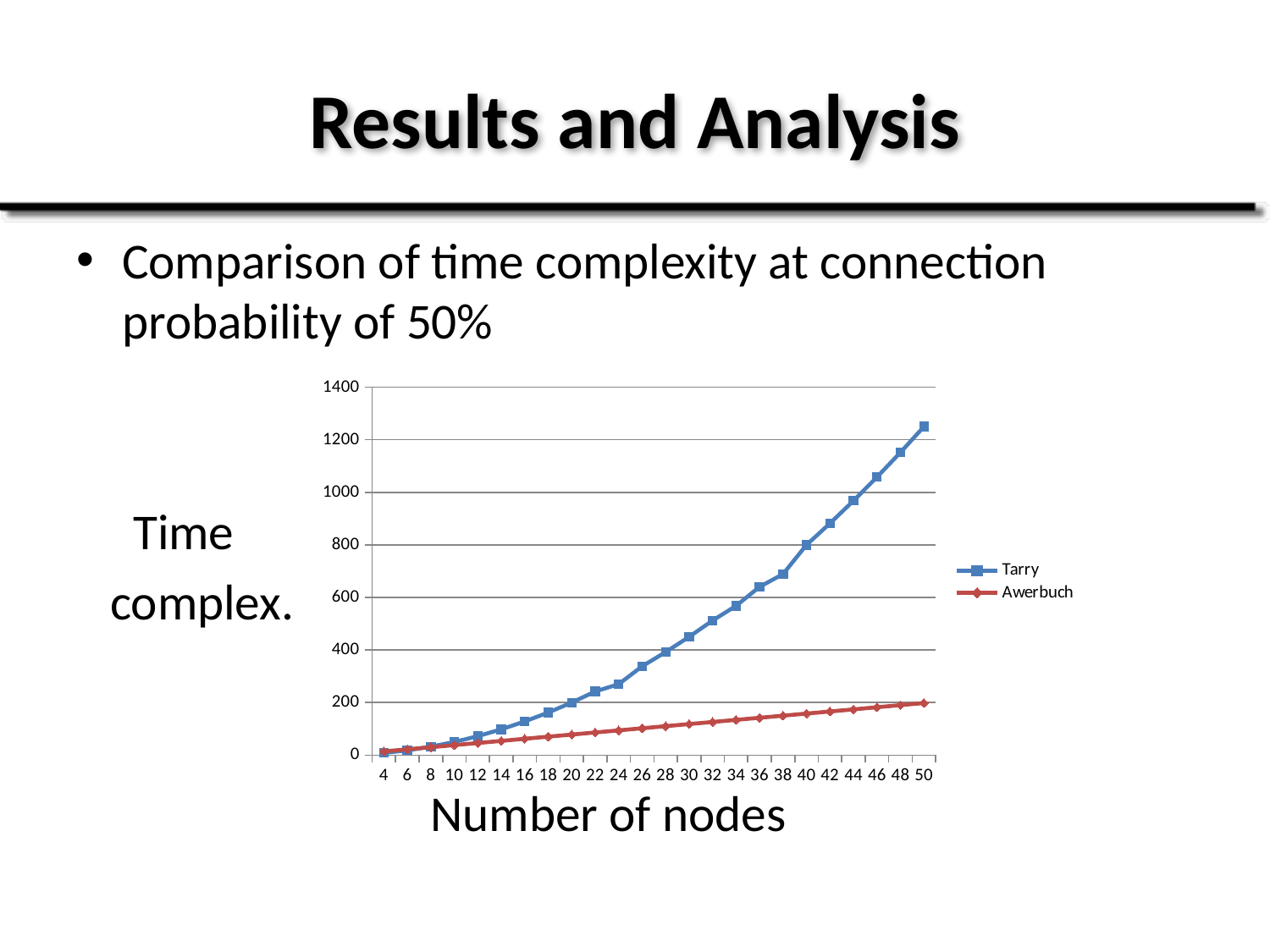
How many data points are plotted along the x axis for each series? 24 What kind of chart is shown on the slide? line chart Which two series are listed in the legend? Tarry and Awerbuch Which series has the higher value at 50 nodes? Tarry Is the value for Tarry at 30 nodes greater or less than 400? greater How many series does the legend list? 2 Is the value for Tarry at 20 nodes greater or less than 400? less Do the Tarry values rise or fall as the number of nodes increases? rise Is the value for Tarry at 50 nodes greater or less than 1200? greater What is the label on the x axis of the chart? Number of nodes Which series has the lower value at 30 nodes? Awerbuch